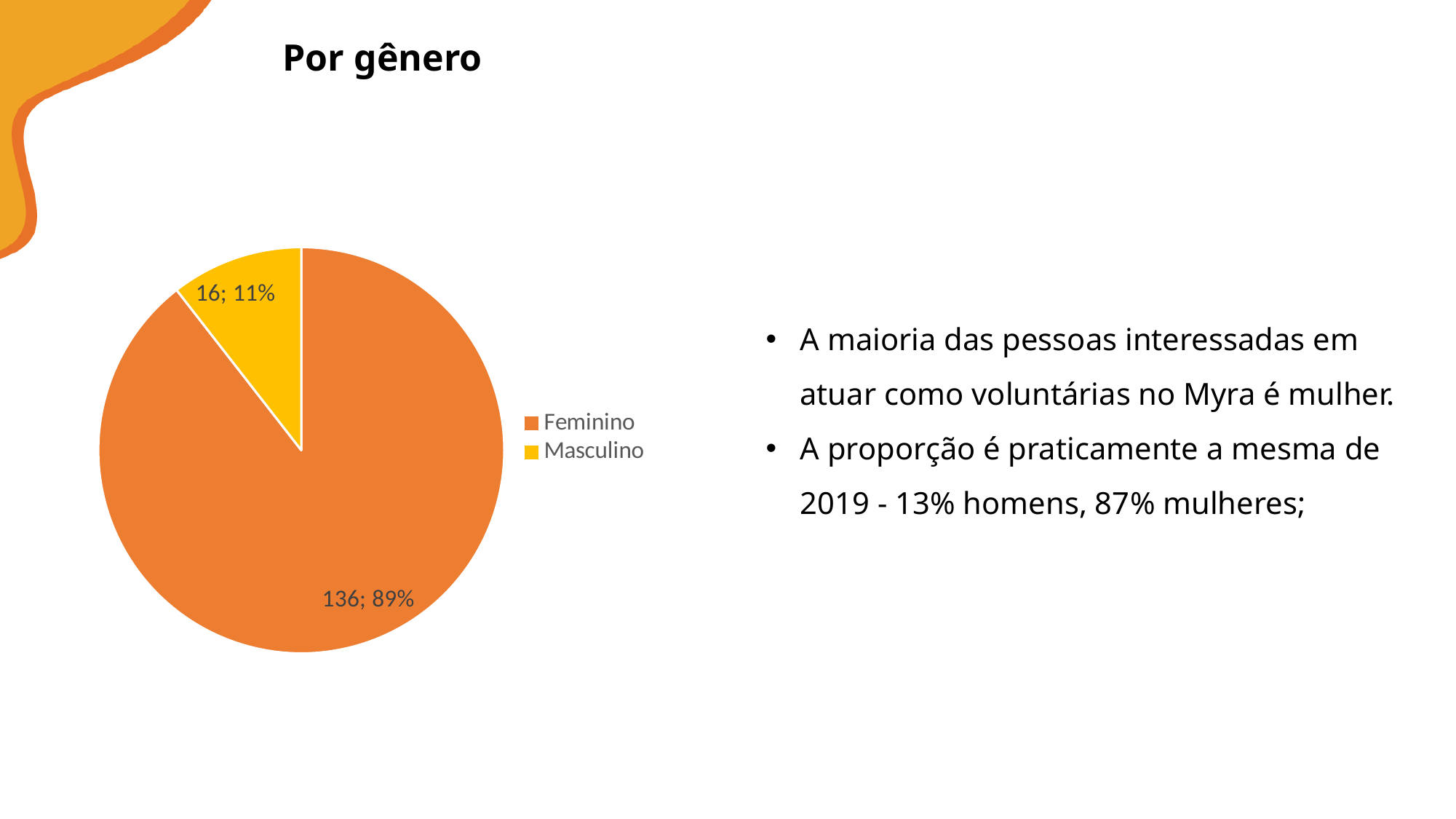
What is the count for Masculino? 16 What percentage share does the Masculino slice have? 11% What is the count for Feminino? 136 Which category has the smallest slice? Masculino What percentage share does the Feminino slice have? 89% What is the difference between the Feminino and Masculino counts? 120 How many entries does the legend list? 2 Which category has the largest slice? Feminino How many slices does the pie chart have? 2 What kind of chart is shown on the slide? pie chart What colour is the Masculino slice? yellow Which is larger, Feminino or Masculino? Feminino